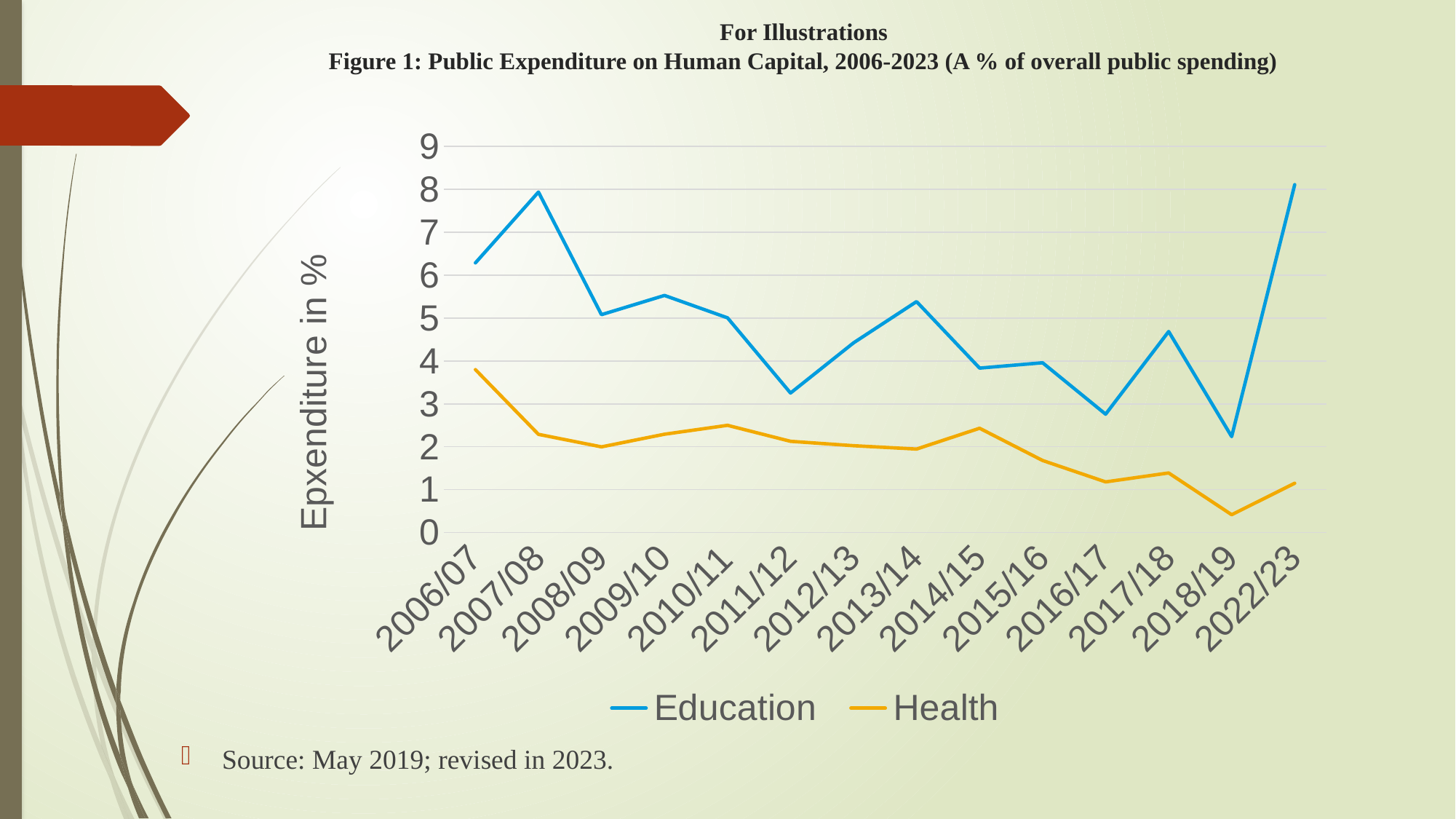
Is the Education value for 2007/08 greater or less than 7? greater Is the Health value for 2018/19 greater or less than 1? less In which year is the Health series at its highest? 2006/07 How many series does the legend list? 2 What kind of chart is shown on the slide? line chart Is the Education value for 2022/23 greater or less than 7? greater In 2010/11, which series has the larger value, Education or Health? Education What is the label on the vertical axis? Epxenditure in % How many fiscal years are plotted along the x axis? 14 In which year is the Health series at its lowest? 2018/19